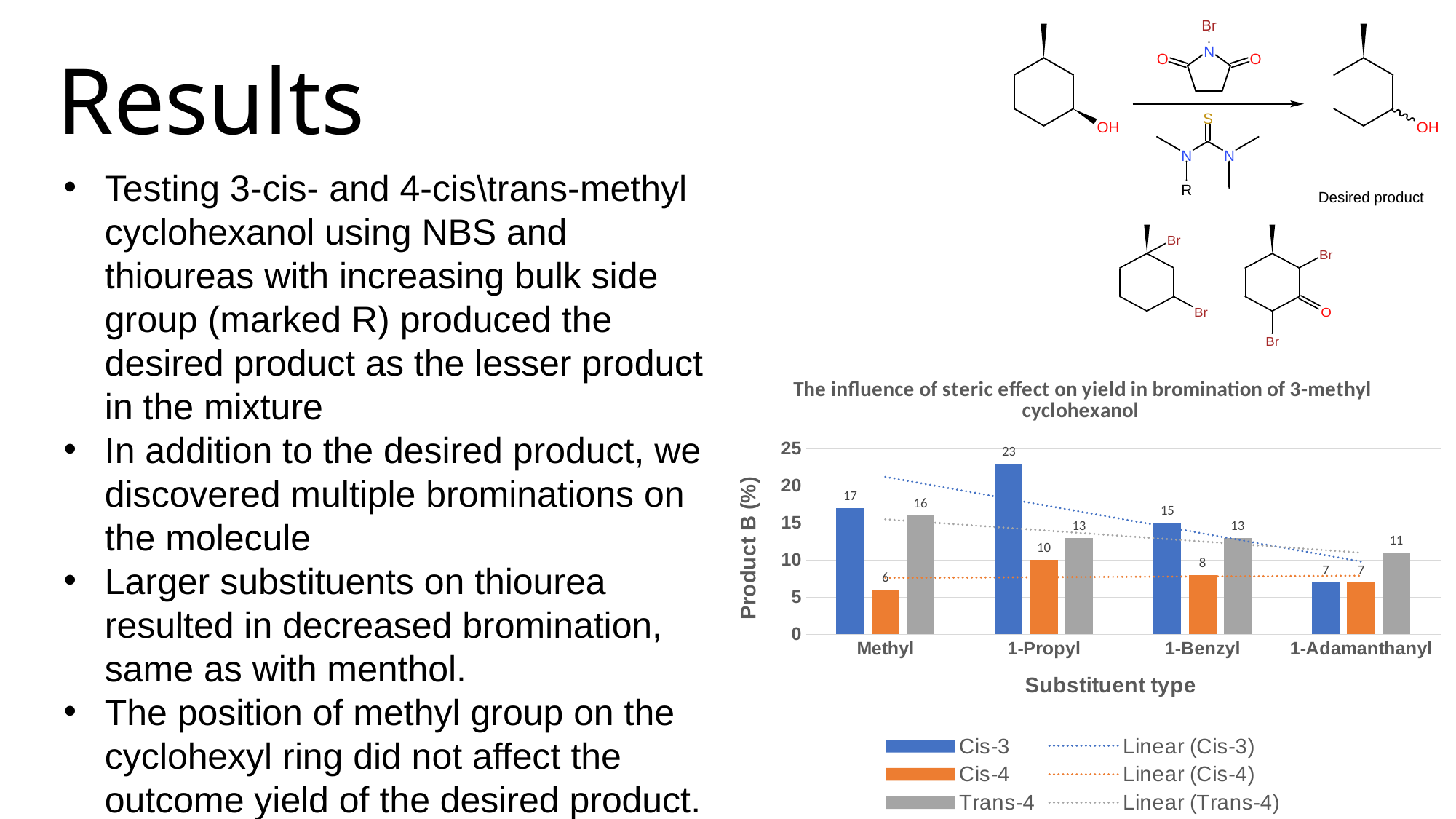
Is the Cis-3 value for 1-Propyl greater or less than 20? greater What is the difference between the Cis-3 and Cis-4 values for 1-Propyl? 13 What kind of chart is shown on the slide? bar chart How many entries does the legend list? 6 What is the label of the y axis of the chart? Product B (%) What is the Cis-4 value for Methyl? 6 How many substituent types are shown on the x axis? 4 What is the Trans-4 value for 1-Adamanthanyl? 11 Which substituent type has the lowest Trans-4 value? 1-Adamanthanyl Which is larger for Methyl, the Cis-3 value or the Trans-4 value? Cis-3 Which substituent type has the highest Cis-3 value? 1-Propyl What is the Cis-3 value for 1-Propyl? 23